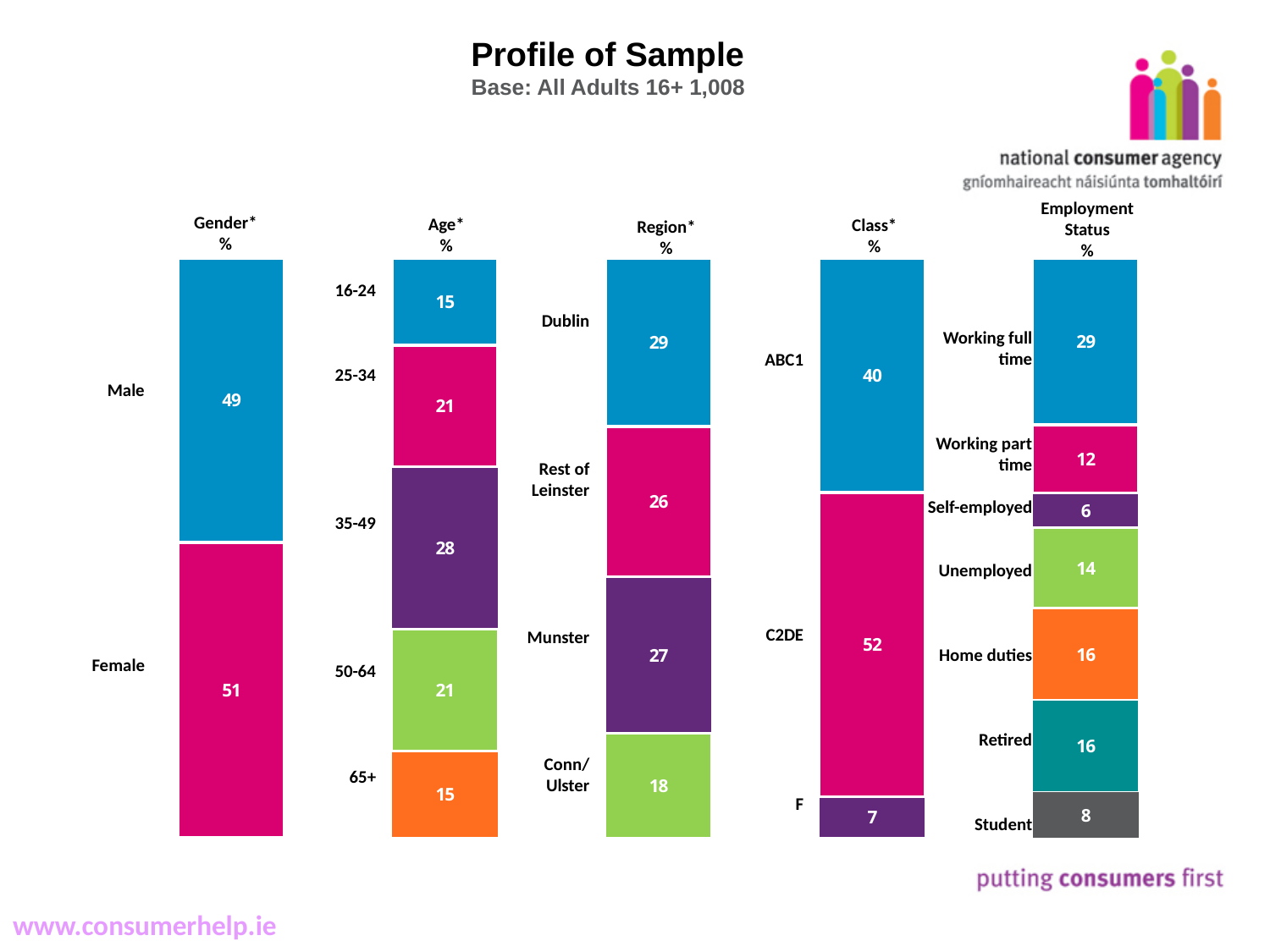
In the Class chart, which class has the highest value? C2DE In the Gender chart, what is the value for Male? 49 In the Age chart, what is the value for the 35-49 group? 28 What kind of chart is the Gender chart? Stacked bar chart In the Region chart, which is larger, Dublin or Munster? Dublin How many age groups are shown in the Age chart? 5 In the Employment Status chart, what is the combined value of Retired and Home duties? 32 How many categories are shown in the Employment Status chart? 7 In the Class chart, what is the difference between C2DE and ABC1? 12 In the Employment Status chart, what is the value for Self-employed? 6 What is the base stated under the slide title? All Adults 16+ 1,008 In the Region chart, which region has the lowest value? Conn/Ulster